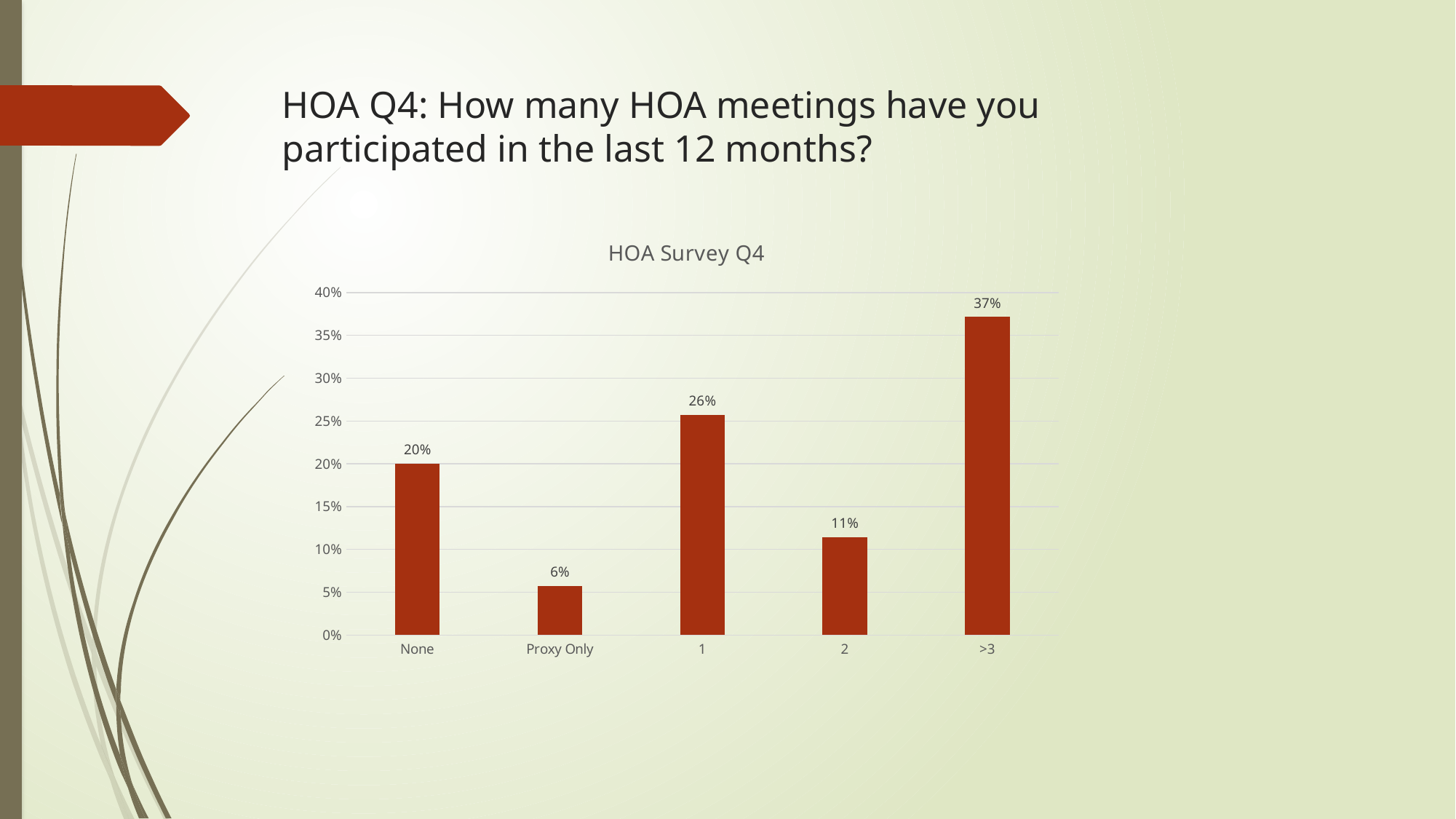
How many categories are shown on the x axis? 5 What is the title of the chart? HOA Survey Q4 What is the value for the category >3? 37% Which category has the highest value? >3 What is the value for None? 20% What kind of chart is shown on the slide? bar chart What is the value for the category 1? 26% What is the value for Proxy Only? 6% Is the value for 2 greater or less than 15%? less Which is larger, the value for 1 or the value for 2? 1 Which category has the lowest value? Proxy Only What is the difference between the values for >3 and None? 17%